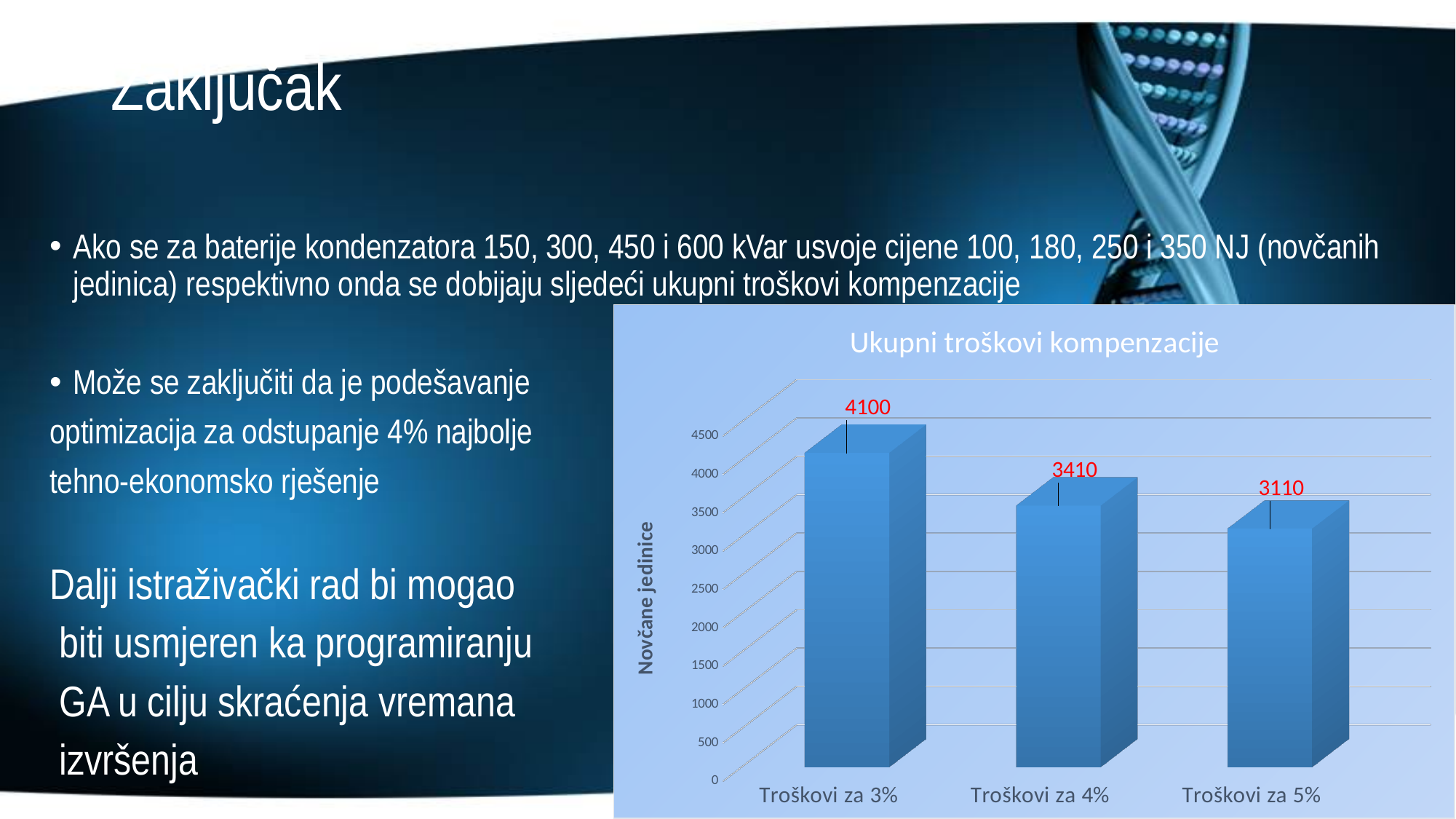
What is the difference between the values for Troškovi za 4% and Troškovi za 5%? 300 Which category has the highest value? Troškovi za 3% What is the value for Troškovi za 3%? 4100 Which is larger, the value for Troškovi za 4% or Troškovi za 5%? Troškovi za 4% How many categories are shown on the x axis? 3 What is the value for Troškovi za 4%? 3410 What kind of chart is shown? bar chart Which category has the lowest value? Troškovi za 5% Is the value for Troškovi za 5% greater or less than 3500? less Do the values rise or fall from left to right along the x axis? fall What is the difference between the values for Troškovi za 3% and Troškovi za 4%? 690 What is the value for Troškovi za 5%? 3110